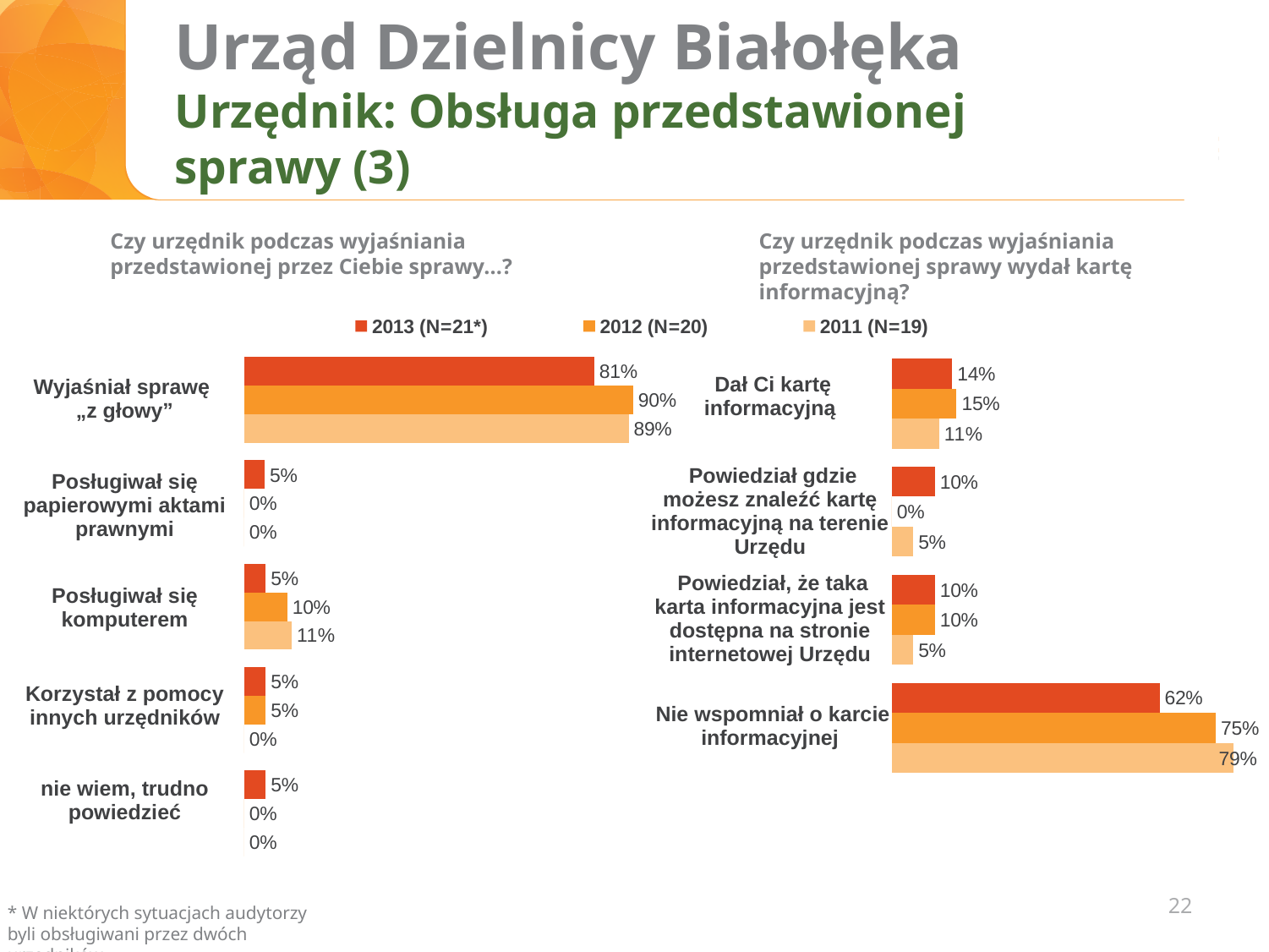
How many series does the legend list? 3 In the right chart, what is the 2013 (N=21*) value for "Dał Ci kartę informacyjną"? 14% In the right chart, is the 2013 value for "Nie wspomniał o karcie informacyjnej" larger or smaller than the 2012 value? smaller In the left chart ("Czy urzędnik podczas wyjaśniania przedstawionej przez Ciebie sprawy...?"), what is the 2012 (N=20) value for "Wyjaśniał sprawę „z głowy”"? 90% In the left chart, what is the 2013 (N=21*) value for "Posługiwał się komputerem"? 5% In the left chart, what is the difference between the 2012 and 2013 values for "Wyjaśniał sprawę „z głowy”"? 9 percentage points In the right chart, which category has the lowest 2012 (N=20) value? Powiedział gdzie możesz znaleźć kartę informacyjną na terenie Urzędu In the right chart, what is the difference between the 2011 and 2013 values for "Nie wspomniał o karcie informacyjnej"? 17 percentage points In the right chart ("Czy urzędnik podczas wyjaśniania przedstawionej sprawy wydał kartę informacyjną?"), what is the 2011 (N=19) value for "Nie wspomniał o karcie informacyjnej"? 79% What type of chart is used on this slide? Bar chart In the left chart, how many categories are shown? 5 In the left chart, which category has the highest 2011 (N=19) value? Wyjaśniał sprawę „z głowy”